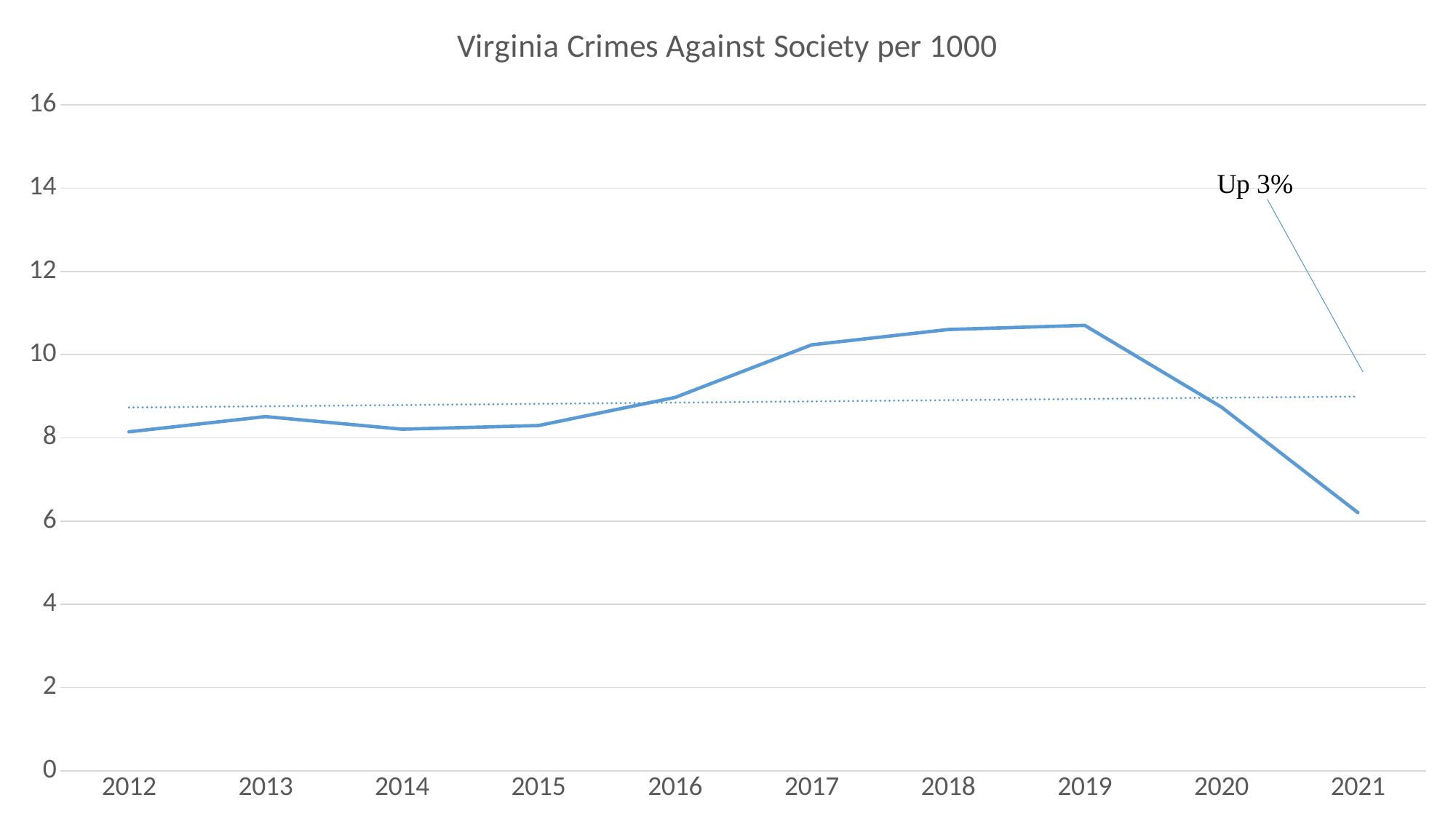
Is the value for 2019 greater or less than 10? greater Is the value for 2013 greater or less than 6? greater What kind of chart is shown on the slide? line chart Do the values rise or fall from 2015 to 2019? rise Do the values rise or fall from 2019 to 2021? fall Is the value for 2020 greater or less than 10? less How many years are plotted along the x axis? 10 What is the title of the chart? Virginia Crimes Against Society per 1000 What does the text annotation near the dotted trend line say? Up 3% Which year has the lowest value? 2021